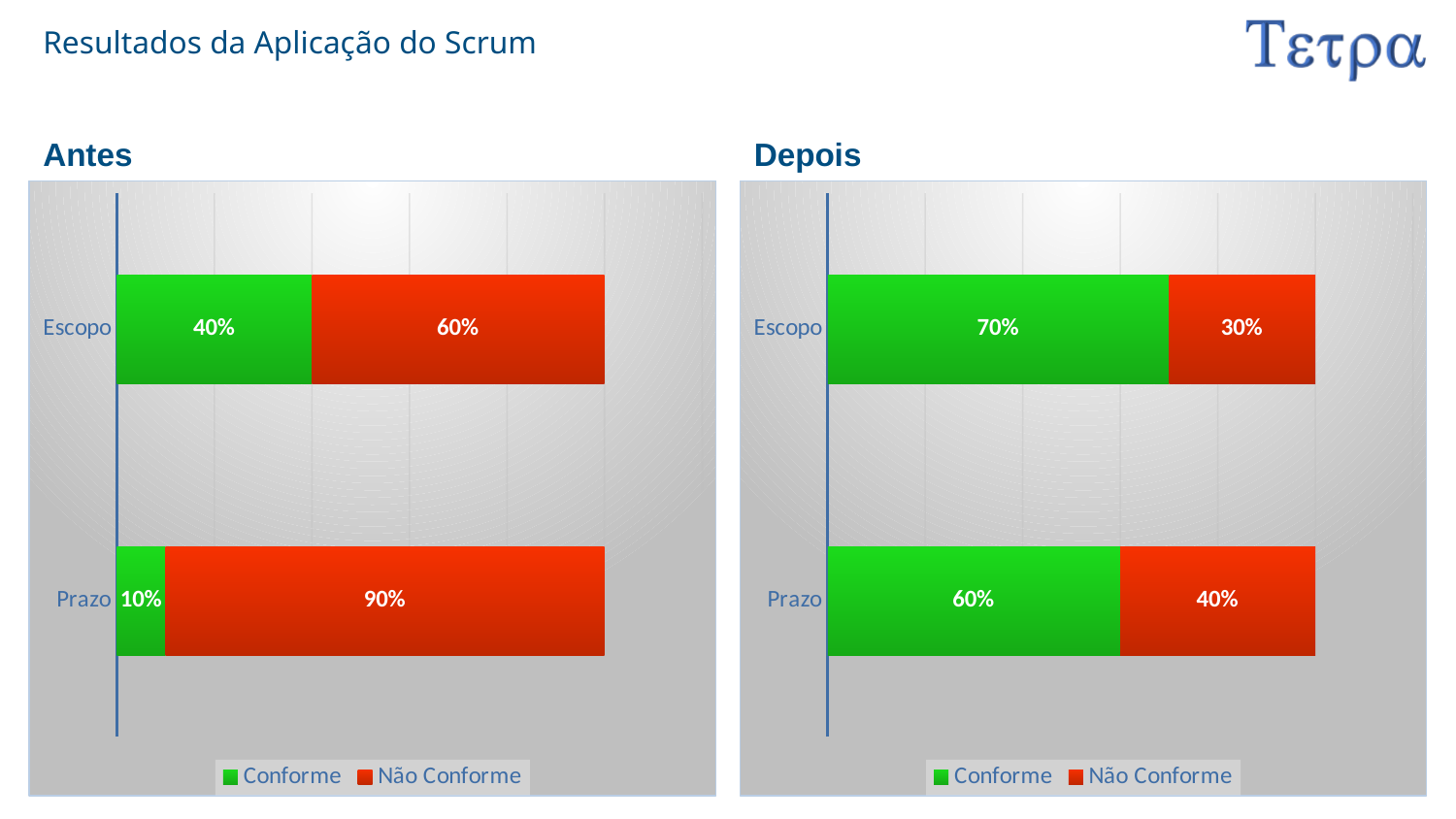
What is the difference between the Conforme value for Prazo in the 'Depois' chart and in the 'Antes' chart? 50% In the 'Antes' chart, which category has the lowest Conforme value? Prazo What is the total of the stacked bar for Escopo in the 'Depois' chart? 100% How many categories are shown in the 'Depois' chart? 2 What type of chart is the 'Depois' chart? Stacked bar chart In the 'Depois' chart, what is the Não Conforme value for Prazo? 40% How many series does the legend of the 'Antes' chart list? 2 In the 'Antes' chart, which is larger for Escopo: Conforme or Não Conforme? Não Conforme In the 'Depois' chart, what is the Conforme value for Escopo? 70% In the 'Depois' chart, which category has the highest Conforme value? Escopo In the 'Antes' chart, what is the Não Conforme value for Prazo? 90% In the 'Antes' chart, what is the Conforme value for Escopo? 40%